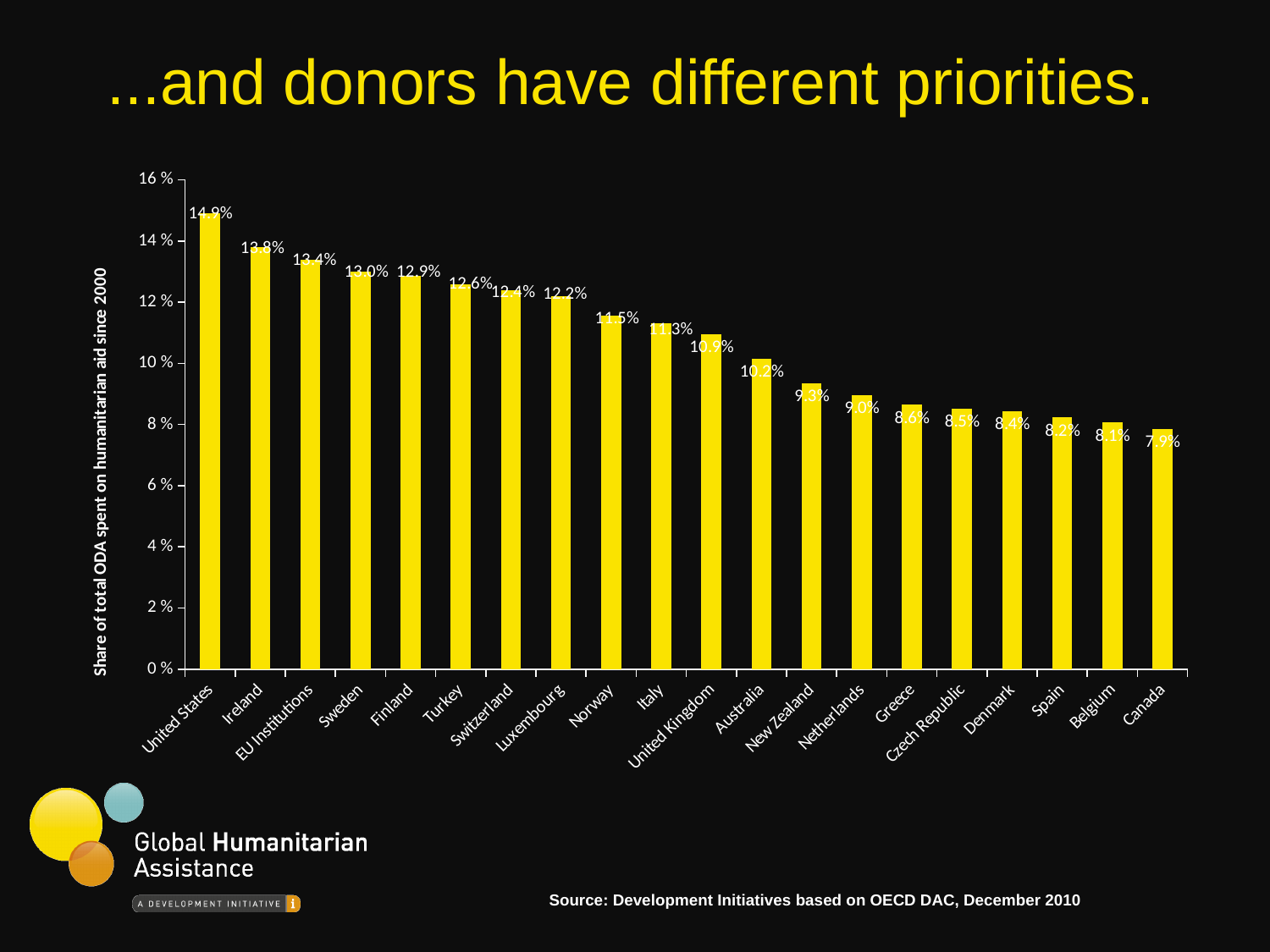
What is the value for Norway? 11.5% What is the value for New Zealand? 9.3% Which donor has the lowest share of total ODA spent on humanitarian aid? Canada Is the value for Greece greater or less than 10%? less Which donor has the highest share of total ODA spent on humanitarian aid? United States How many donors are shown on the chart? 20 What is the value for the United States? 14.9% What is the difference between the values for Ireland and Canada? 5.9% Which is larger, the value for Sweden or the value for Italy? Sweden What is the label on the vertical axis of the chart? Share of total ODA spent on humanitarian aid since 2000 What is the difference between the values for the United Kingdom and Australia? 0.7% What kind of chart is shown on the slide? bar chart